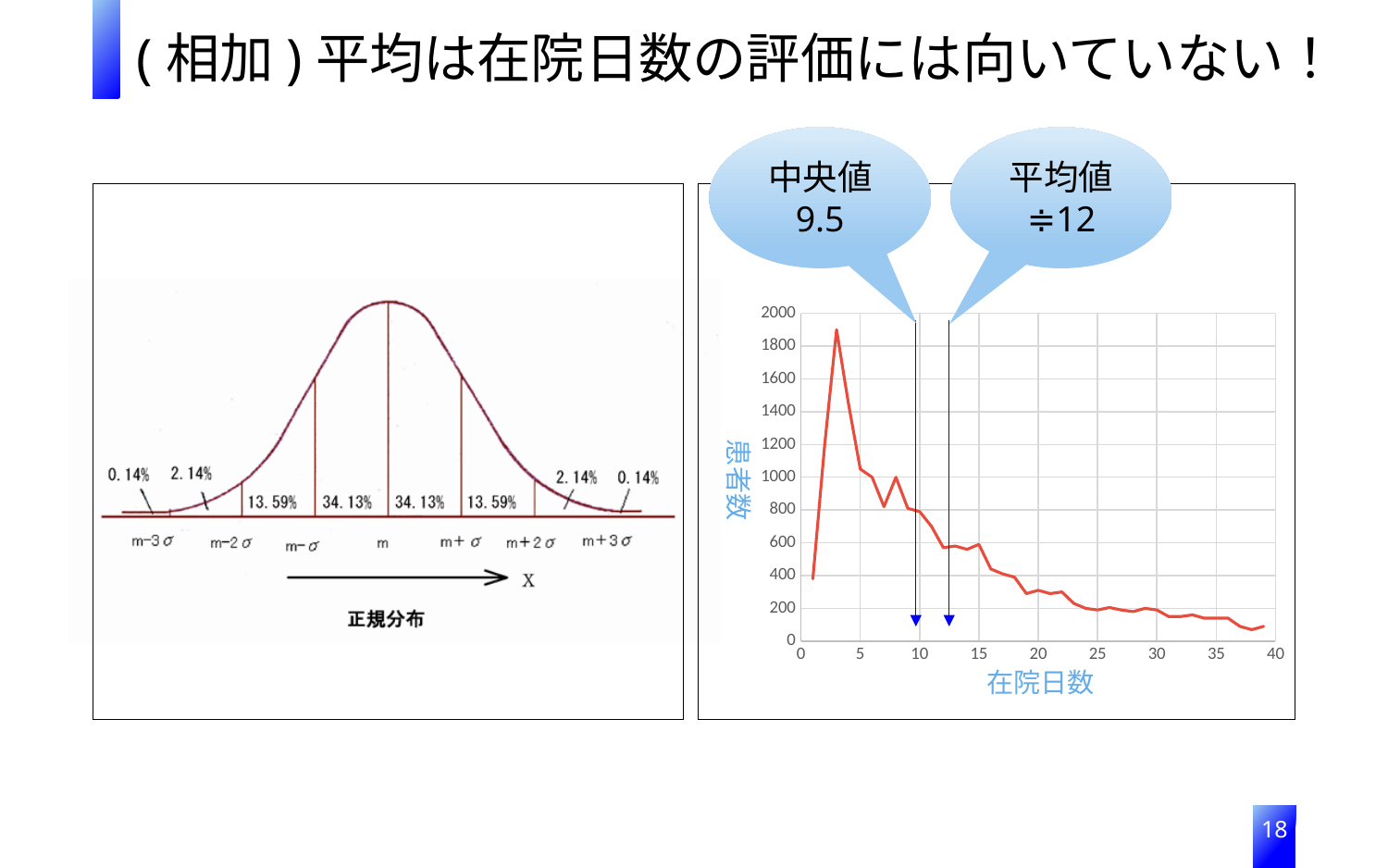
On the right-hand chart, what is the label of the x axis? 在院日数 On the left-hand chart (正規分布), what percentage is shown beyond m+3σ? 0.14% On the right-hand chart, do the values rise or fall along the x axis after the peak near day 3? fall On the right-hand chart, is the value for 在院日数 30 greater or less than 400? less On the left-hand chart (正規分布), what percentage is shown between m+σ and m+2σ? 13.59% On the right-hand chart, what is the median (中央値) value shown in the callout? 9.5 What kind of chart is the right-hand chart (患者数 vs 在院日数)? line chart On the right-hand chart, is the value for 在院日数 20 greater or less than 400? less On the left-hand chart (正規分布), what percentage is shown between m and m+σ? 34.13% On the right-hand chart, is the value for 在院日数 3 greater or less than 1600? greater On the right-hand chart, which is larger: the value at 在院日数 3 or the value at 在院日数 35? 在院日数 3 On the right-hand chart, what is the mean (平均値) value shown in the callout? ≒12